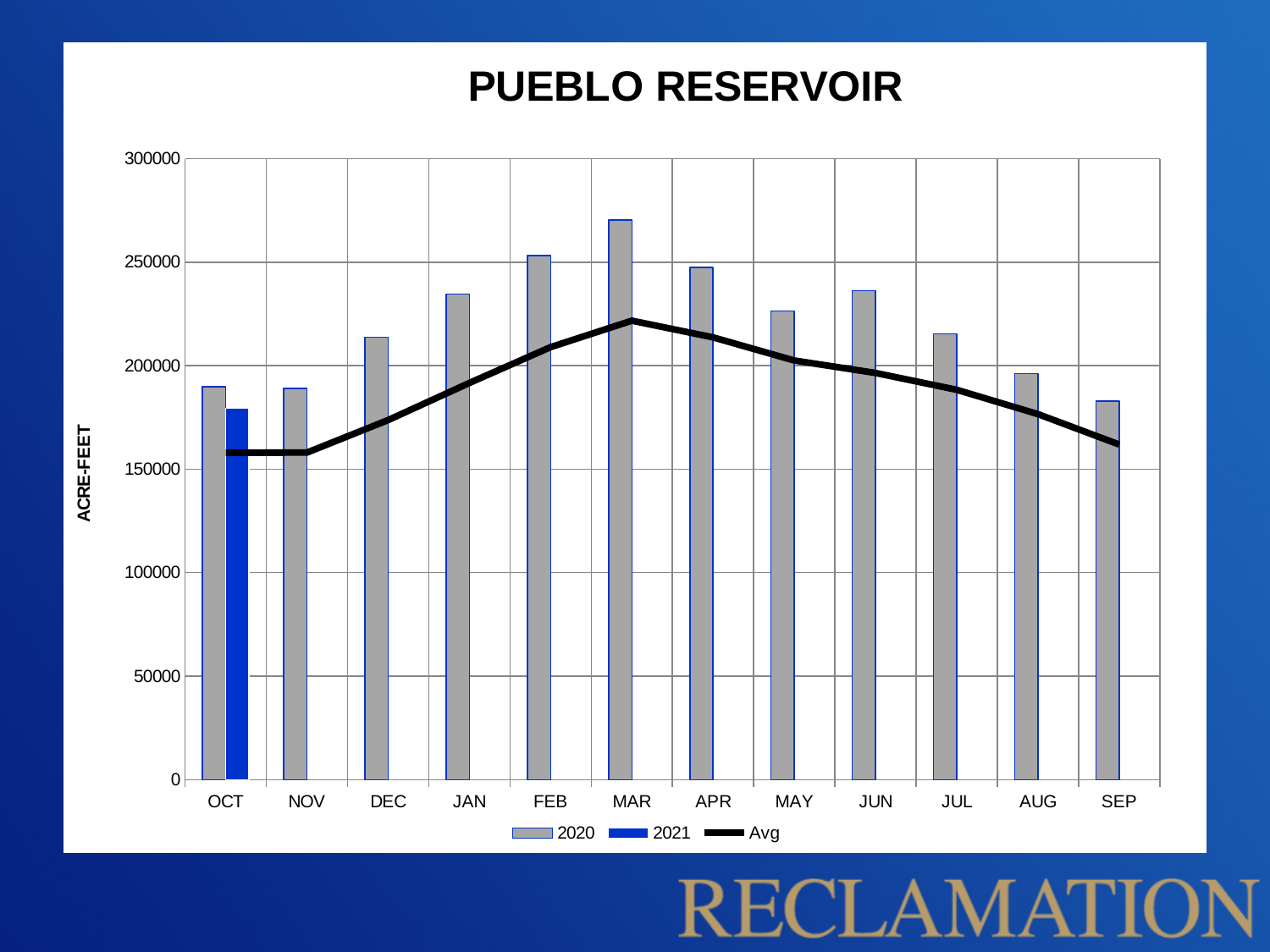
Is the 2020 value for MAR greater or less than 250000? greater Which 2020 bar is larger: JUN or JUL? JUN What kind of chart is shown on the slide? Bar chart with a line How many series does the legend list? 3 What is the label on the y axis? ACRE-FEET In which month is the 2020 bar highest? MAR Do the 2020 bars rise or fall from OCT to MAR? rise How many months are shown along the x axis? 12 Is the 2020 value for DEC greater or less than 200000? greater For OCT, which is larger: the 2020 bar or the 2021 bar? 2020 Is the 2021 value for OCT greater or less than 200000? less